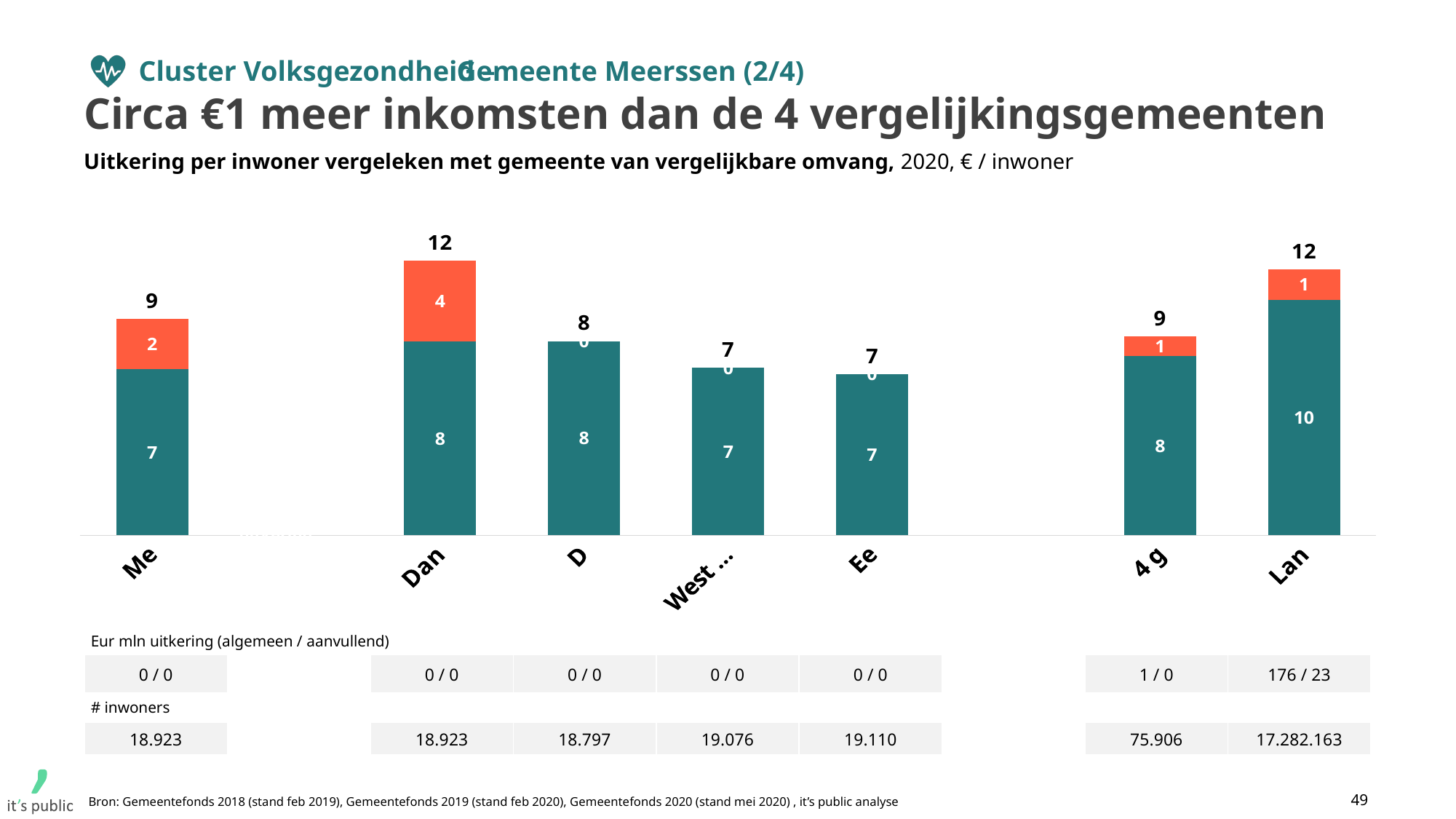
What kind of chart is shown on the slide? stacked bar chart What is the value of the orange (top) segment of the bar for Dan? 4 Which is larger, the total for Me or the total for 4 g? They are equal (9) What is the total value shown above the bar for Me? 9 What is the unit stated in the chart subtitle? € / inwoner What is the value of the orange (top) segment of the bar for Me? 2 What is the total value shown above the bar for Dan? 12 Which category has the lowest total value? West ... and Ee (both 7) How many bars are plotted in the chart? 7 What is the value of the teal (bottom) segment of the bar for Lan? 10 What is the difference between the total for Dan and the total for D? 4 What is the difference between the total for Lan and the total for Ee? 5